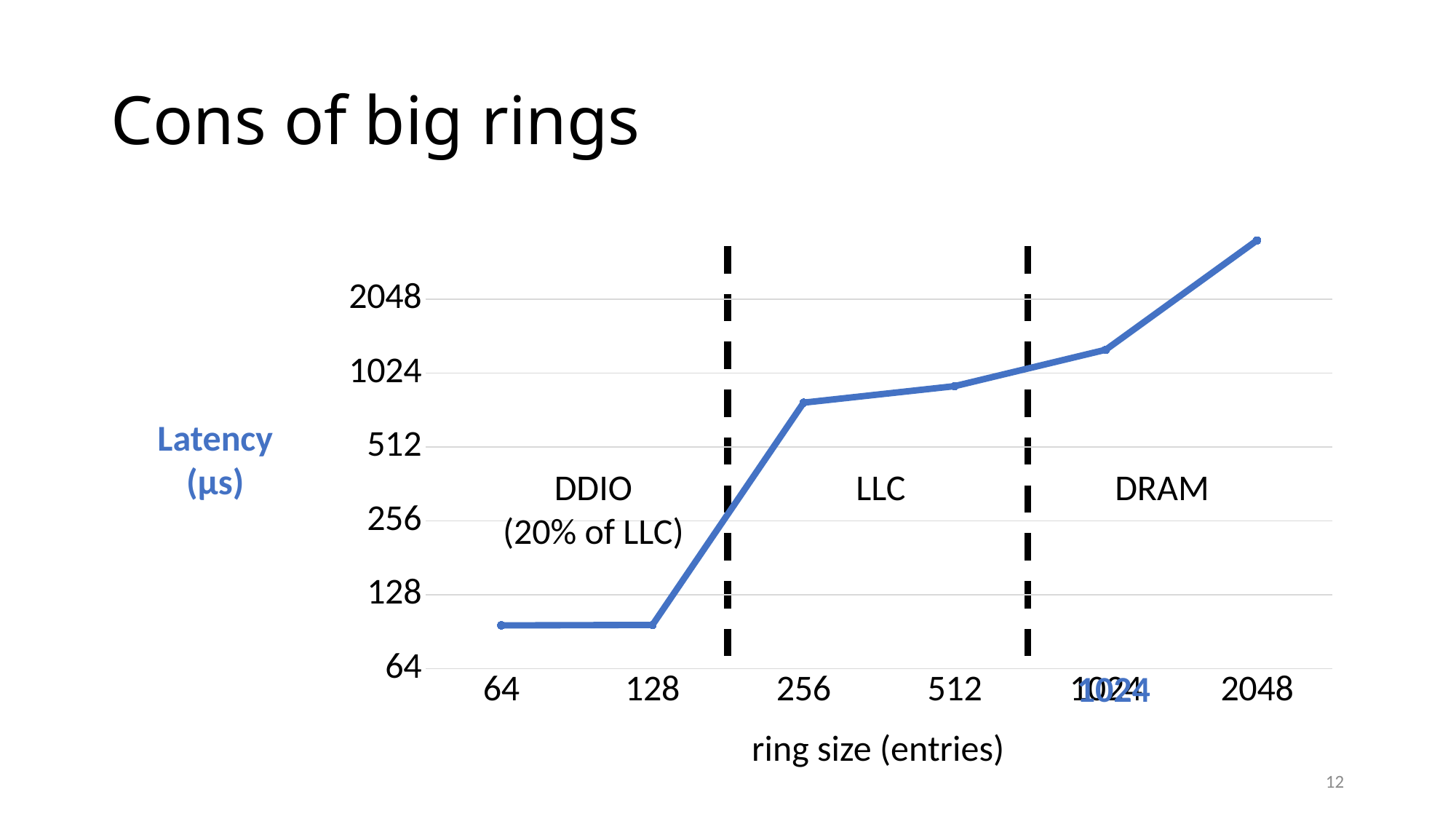
Does latency rise or fall as ring size increases along the x axis? rise Which ring size has the highest latency? 2048 How many ring sizes are plotted on the x axis? 6 Is the latency for a ring size of 64 greater or less than 128 µs? less What kind of chart is shown on the slide? line chart Which has the larger latency, a ring size of 256 or a ring size of 128? 256 What is the title of the slide? Cons of big rings Is the latency for a ring size of 512 greater or less than 1024 µs? less Is the latency for a ring size of 2048 greater or less than 2048 µs? greater What is the label of the x axis? ring size (entries)